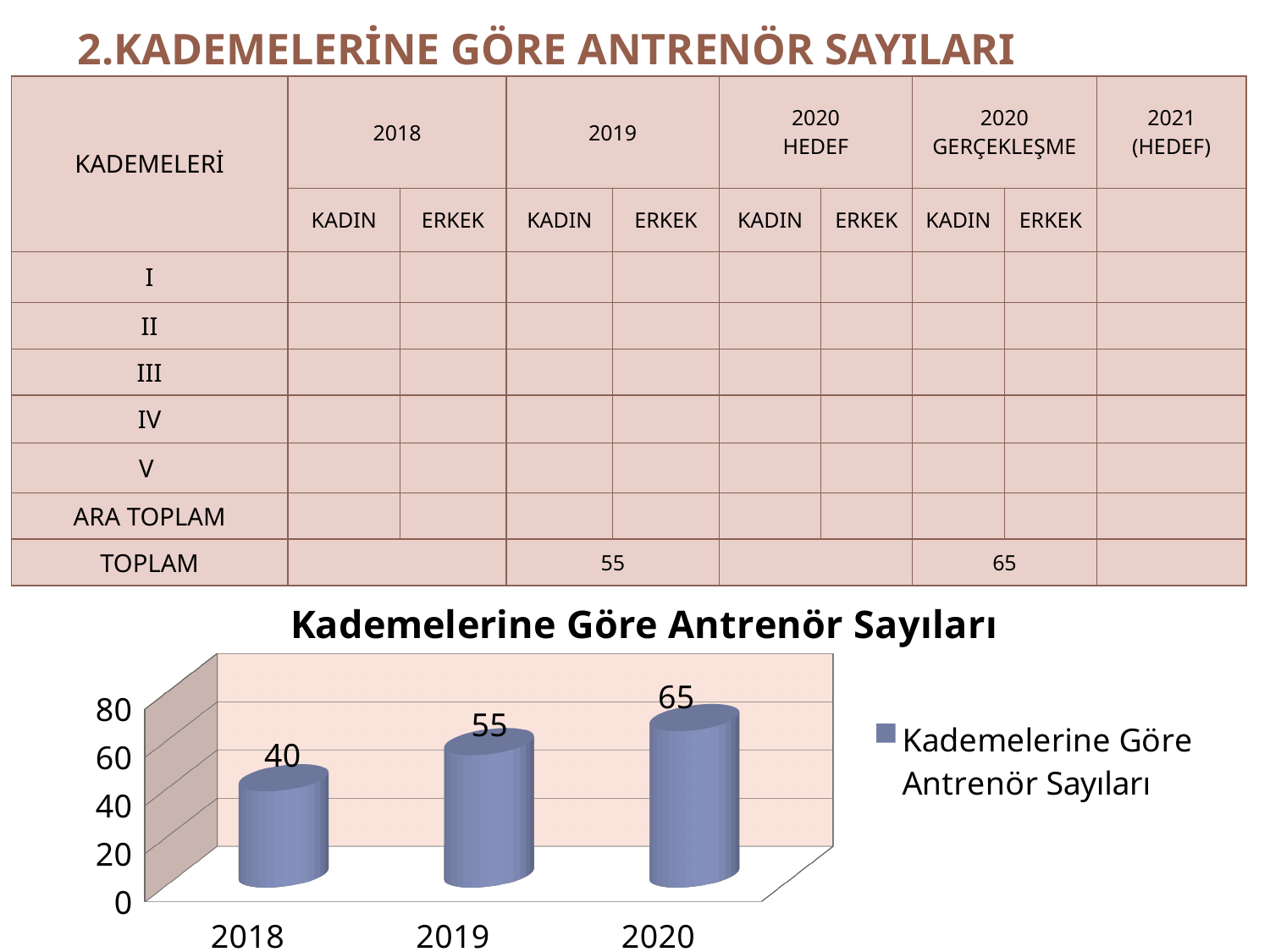
Is the value for 2020 greater or less than 60? greater What is the value for 2018 in the chart? 40 Do the values rise or fall from 2018 to 2020? rise What is the value for 2019 in the chart? 55 Which year has the lowest value in the chart? 2018 Which year has the highest value in the chart? 2020 How many years are shown on the x axis of the chart? 3 Which is larger, the value for 2019 or the value for 2020? 2020 What is the difference between the values for 2020 and 2018? 25 What is the title of the chart? Kademelerine Göre Antrenör Sayıları What is the value for 2020 in the chart? 65 What is the difference between the values for 2019 and 2018? 15